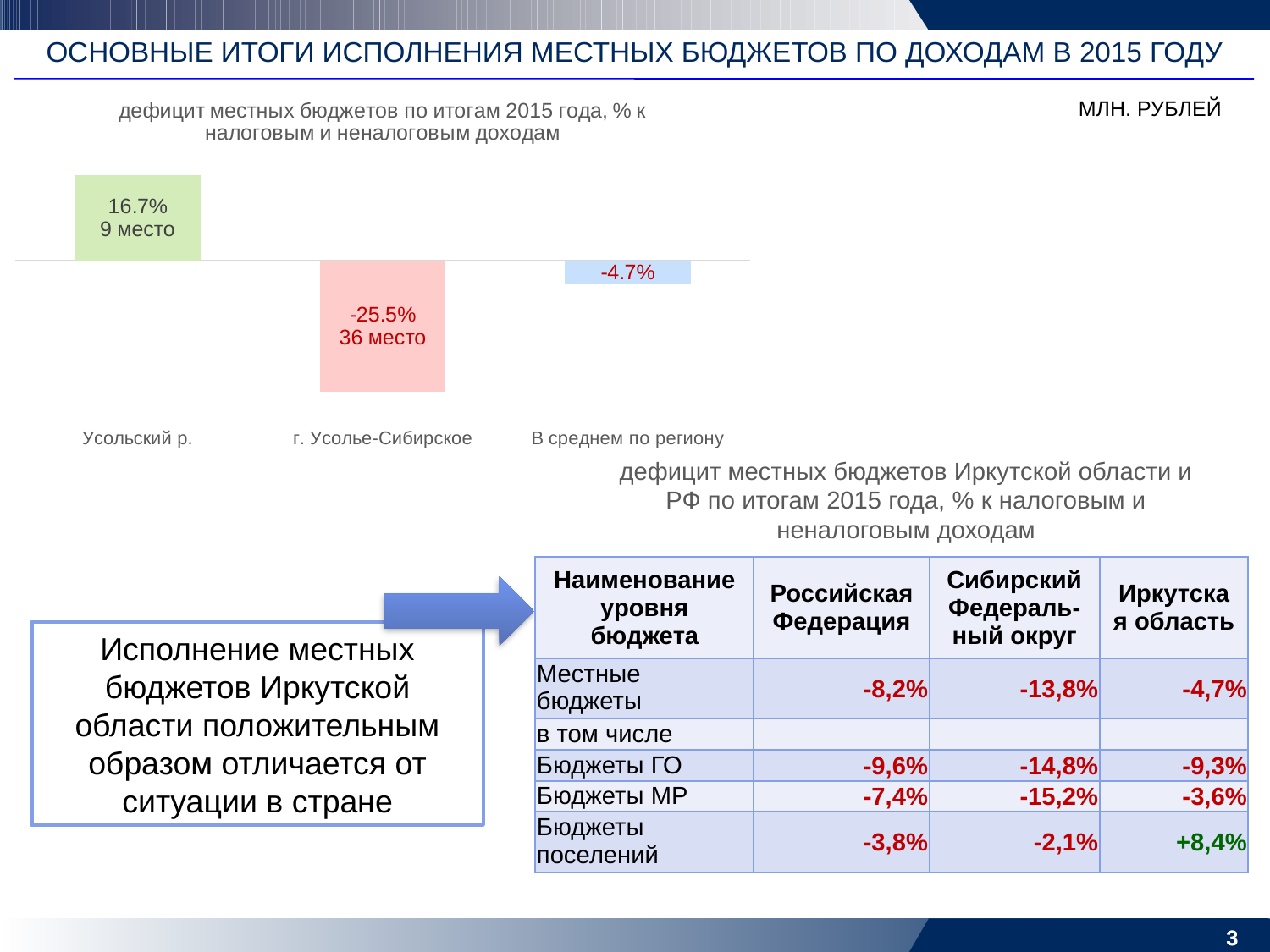
What is the title of the bar chart? дефицит местных бюджетов по итогам 2015 года, % к налоговым и неналоговым доходам What rank (место) is shown on the bar for г. Усолье-Сибирское? 36 место How many categories does the bar chart show? 3 What is the value for Усольский р. in the bar chart? 16.7% Which category has the highest value in the bar chart? Усольский р. Which category has the lowest value in the bar chart? г. Усолье-Сибирское What is the value for В среднем по региону in the bar chart? -4.7% Which is larger: the value for г. Усолье-Сибирское or the value for В среднем по региону? В среднем по региону What rank (место) is shown on the bar for Усольский р.? 9 место What type of chart is shown on the slide? bar chart What is the difference between the values for Усольский р. and г. Усолье-Сибирское? 42.2% What is the value for г. Усолье-Сибирское in the bar chart? -25.5%